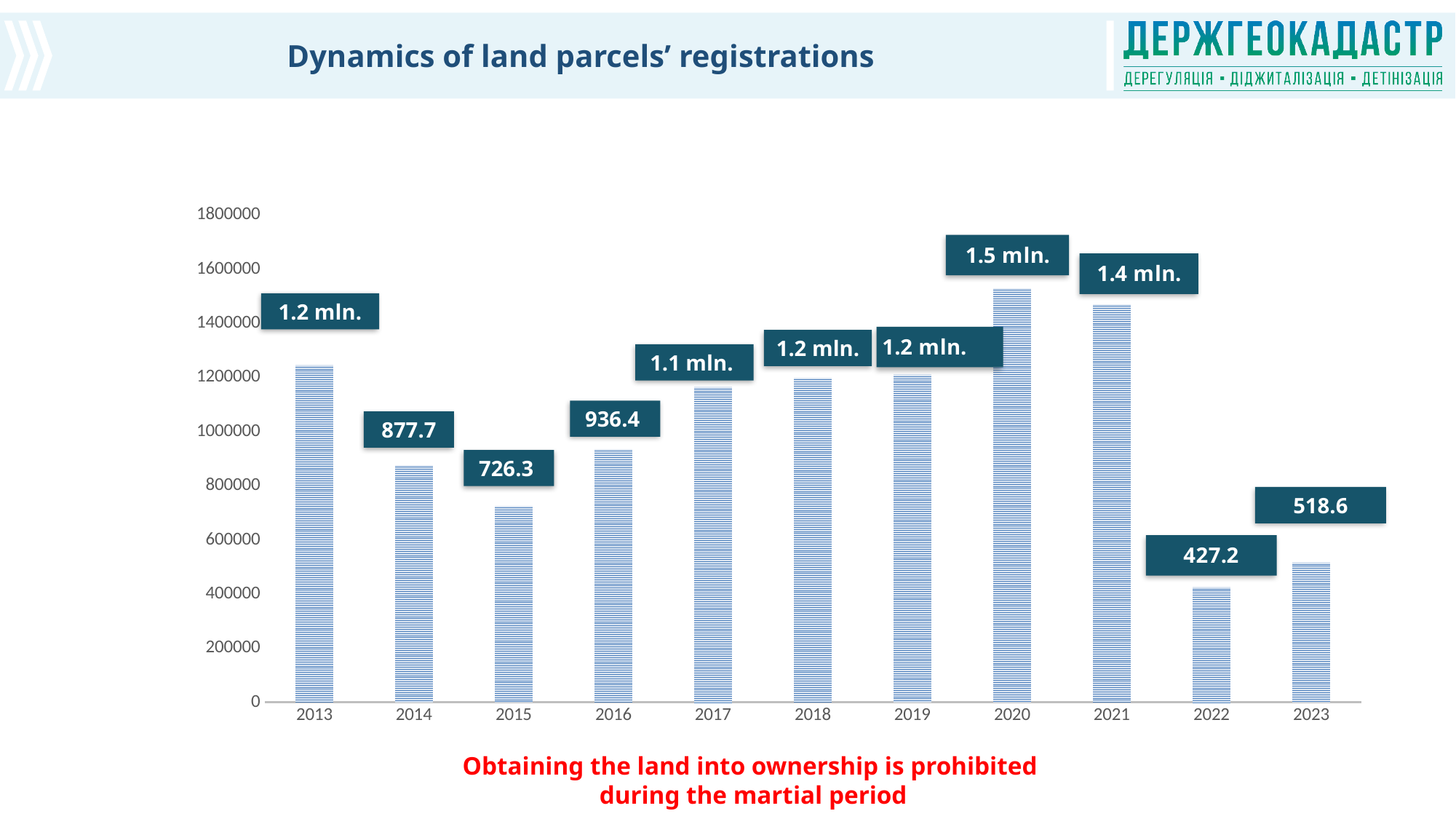
Is the value for 2015 greater or less than 800000? less What is the difference between the labelled values for 2016 and 2015? 210.1 What type of chart is shown on the slide? bar chart What is the data label for 2022? 427.2 How many years are shown on the x axis of the chart? 11 What is the data label for 2020? 1.5 mln. Which year has the larger value, 2014 or 2015? 2014 Which year has the highest bar? 2020 What is the data label for 2014? 877.7 What is the data label for 2023? 518.6 What is the title of the chart? Dynamics of land parcels' registrations Which year has the lowest bar? 2022